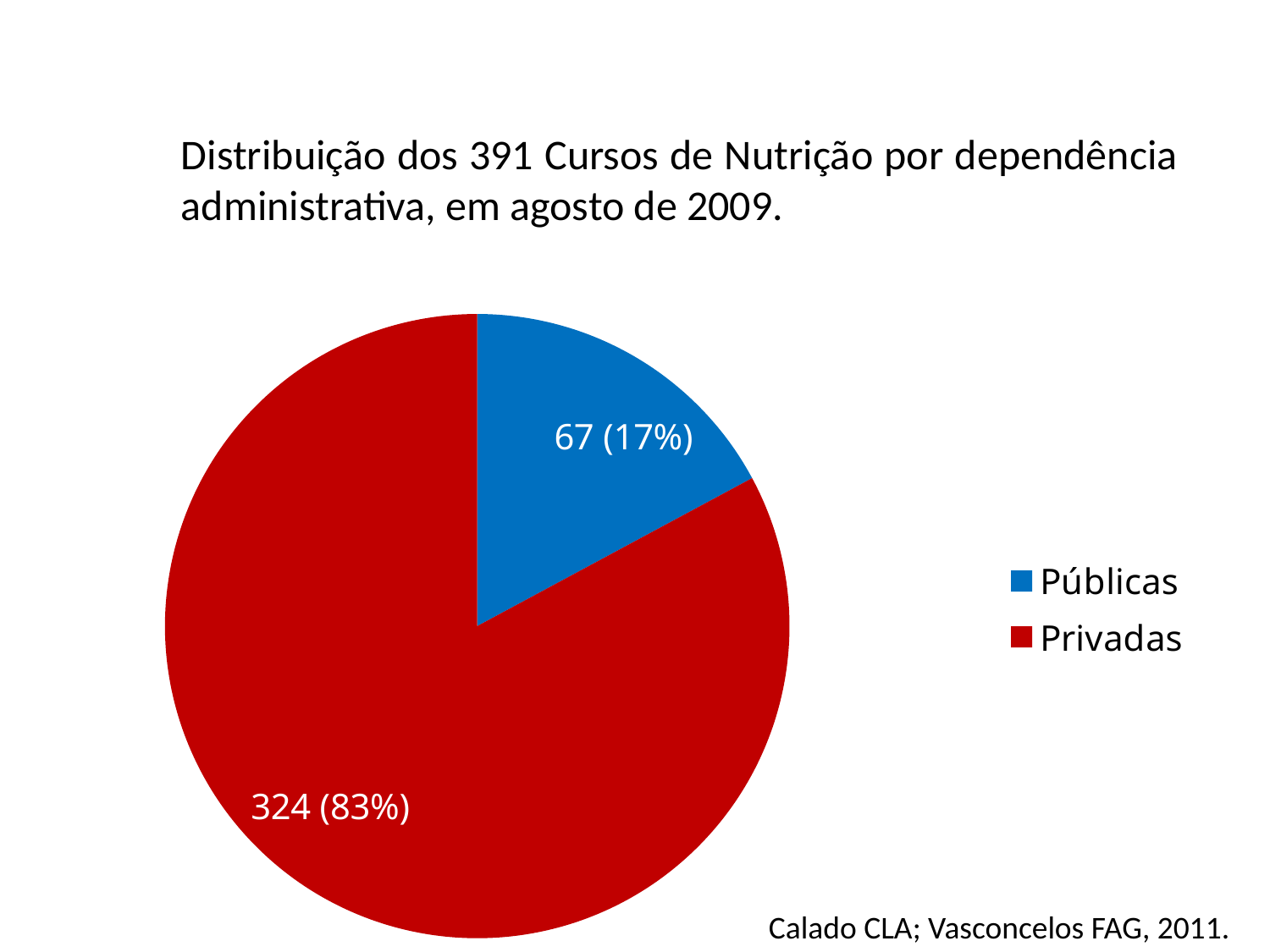
Which category has the smallest slice? Públicas How many courses are in the Privadas slice? 324 Which category has the largest slice? Privadas How many categories does the pie chart have? 2 What share of the pie does the Públicas slice represent? 17% Which is larger, the Públicas slice or the Privadas slice? Privadas How many courses are in the Públicas slice? 67 What is the difference in number of courses between Privadas and Públicas? 257 What colour is the Públicas slice? blue What is the total number of courses across both slices? 391 What kind of chart is shown on the slide? pie chart What share of the pie does the Privadas slice represent? 83%